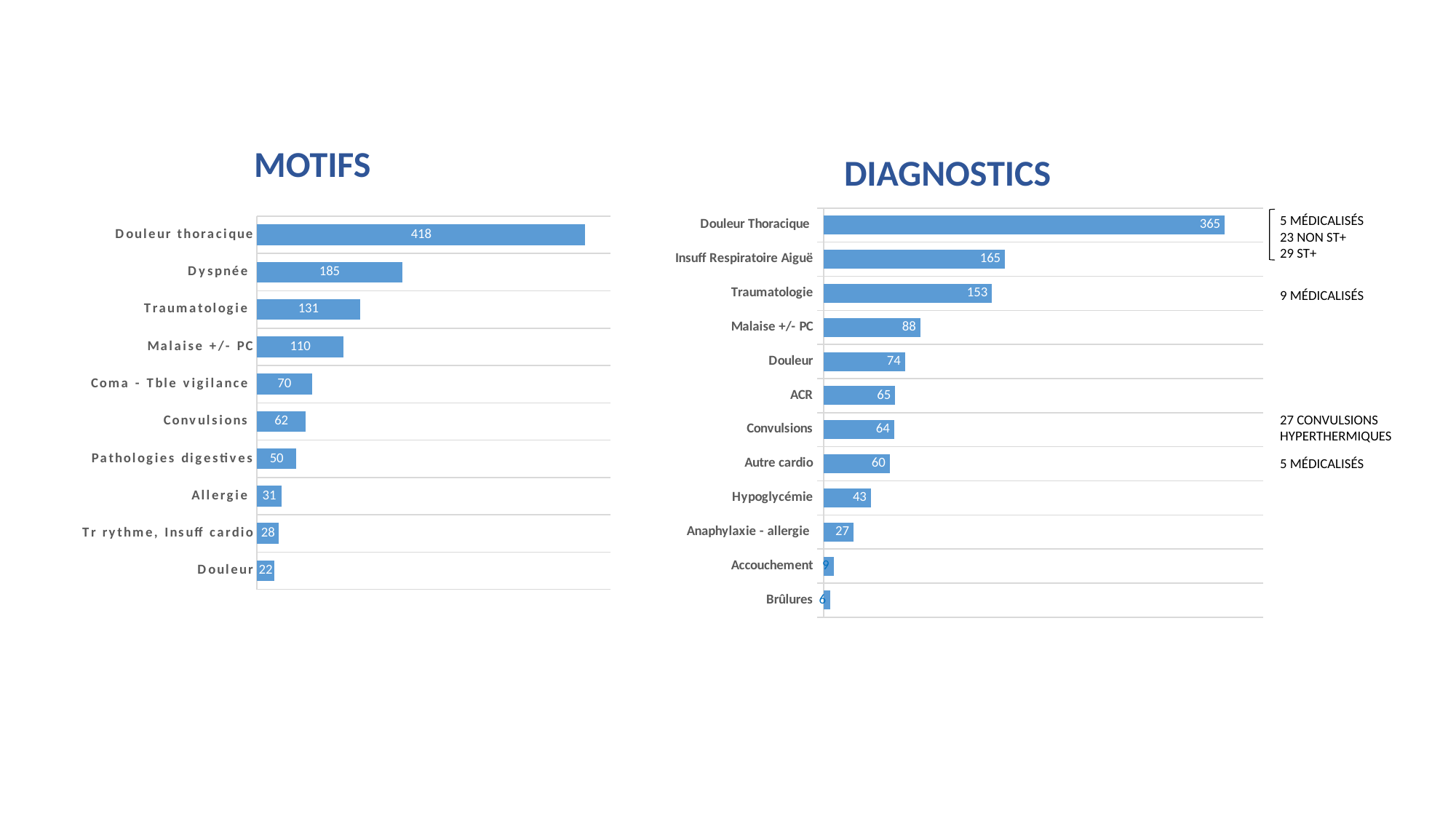
In the MOTIFS chart, which category has the lowest value? Douleur In the DIAGNOSTICS chart, what is the difference between Douleur Thoracique and Insuff Respiratoire Aiguë? 200 In the MOTIFS chart, which category has the highest value? Douleur thoracique In the MOTIFS chart, what is the value for Dyspnée? 185 What type of chart is the DIAGNOSTICS chart? Bar chart In the MOTIFS chart, how many categories are shown? 10 In the DIAGNOSTICS chart, what is the value for Hypoglycémie? 43 In the DIAGNOSTICS chart, which is larger, Malaise +/- PC or Douleur? Malaise +/- PC In the DIAGNOSTICS chart, which category has the lowest value? Brûlures What is the title of the chart on the left side of the slide? MOTIFS In the MOTIFS chart, what is the difference between Traumatologie and Malaise +/- PC? 21 In the DIAGNOSTICS chart, how many categories are shown? 12